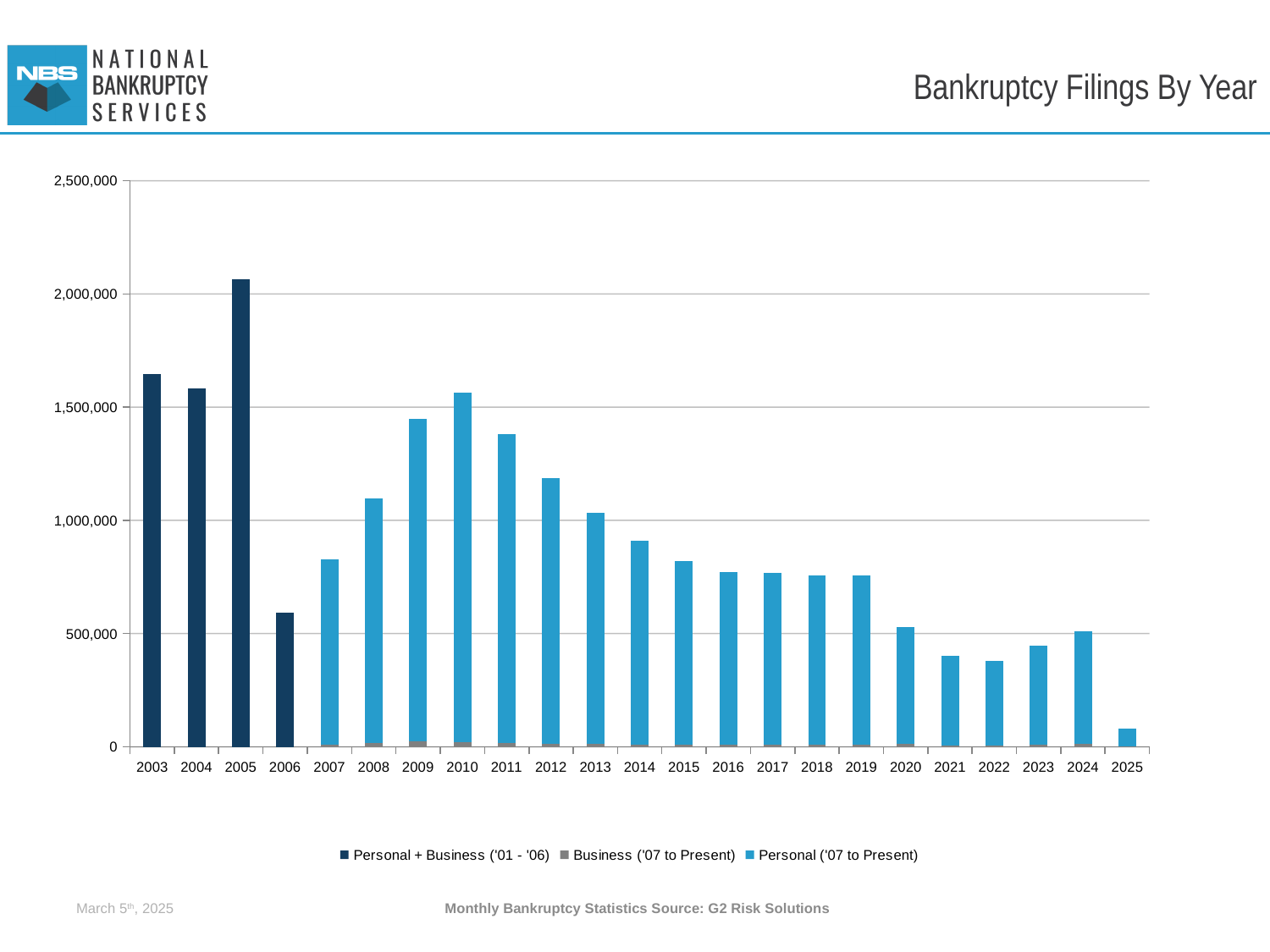
Is the value for 2005 greater or less than 2,000,000? greater Is the value for 2021 greater or less than 500,000? less What type of chart is shown on the slide? bar chart Which year has the highest total bankruptcy filings? 2005 Do the total filings rise or fall from 2010 to 2021? fall What is the title of the chart? Bankruptcy Filings By Year Is the value for 2014 greater or less than 1,000,000? less How many years are shown along the x axis? 23 Which year has the larger total, 2010 or 2011? 2010 Which year has the lowest total bankruptcy filings? 2025 How many series does the legend list? 3